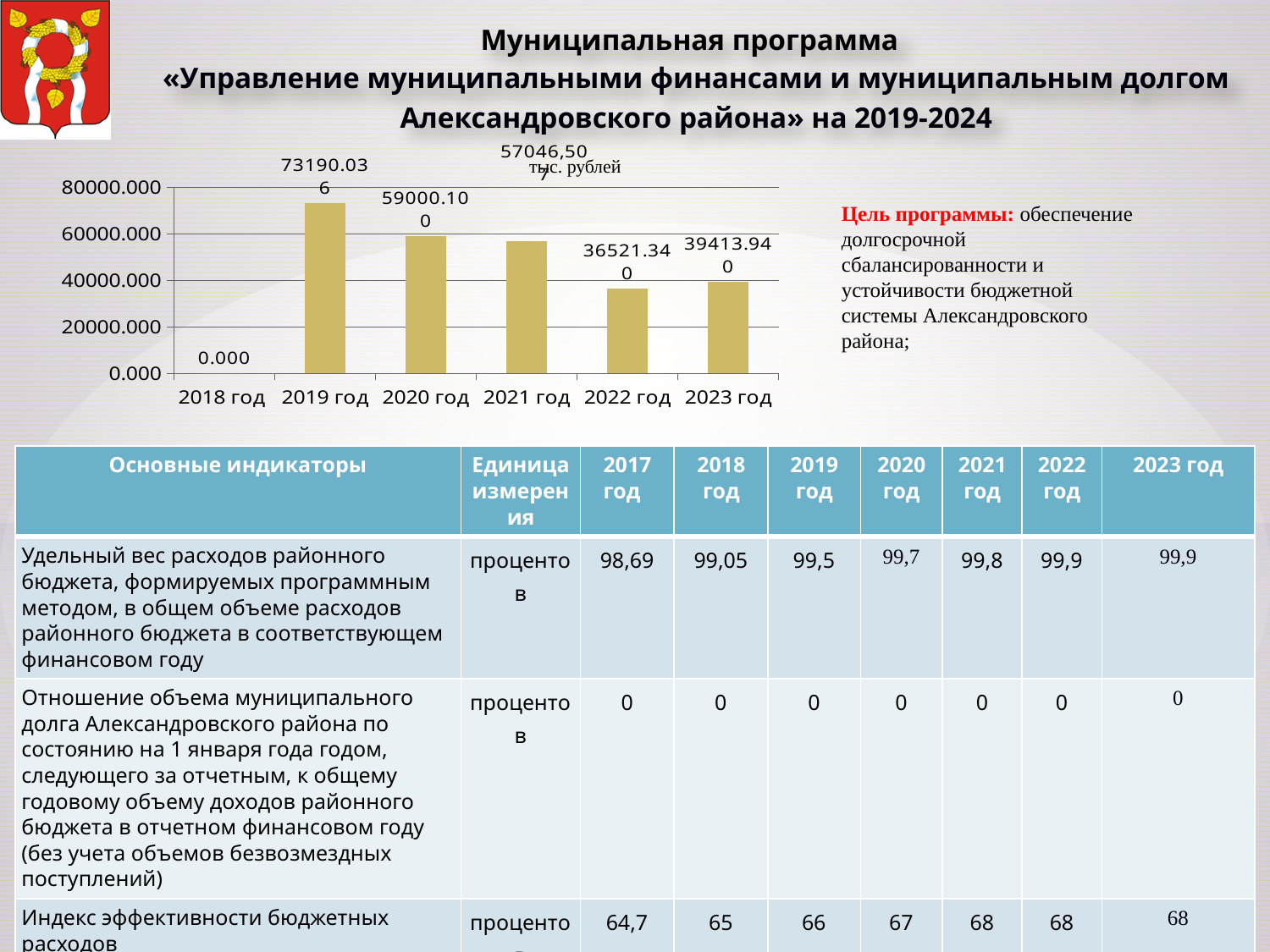
Which is larger in the chart, the value for 2022 год or for 2023 год? 2023 год Do the values rise or fall from 2019 год to 2022 год? fall Is the value for 2021 год greater or less than 40000.000? greater What is the value shown for 2019 год in the chart? 73190.036 What is the value shown for 2022 год in the chart? 36521.340 How many years (categories) are shown on the x axis of the chart? 6 Which year has the lowest value in the chart? 2018 год Which year has the highest value in the chart? 2019 год What is the value shown for 2018 год in the chart? 0.000 What is the value shown for 2020 год in the chart? 59000.100 What is the value shown for 2023 год in the chart? 39413.940 What type of chart is shown on the slide? bar chart